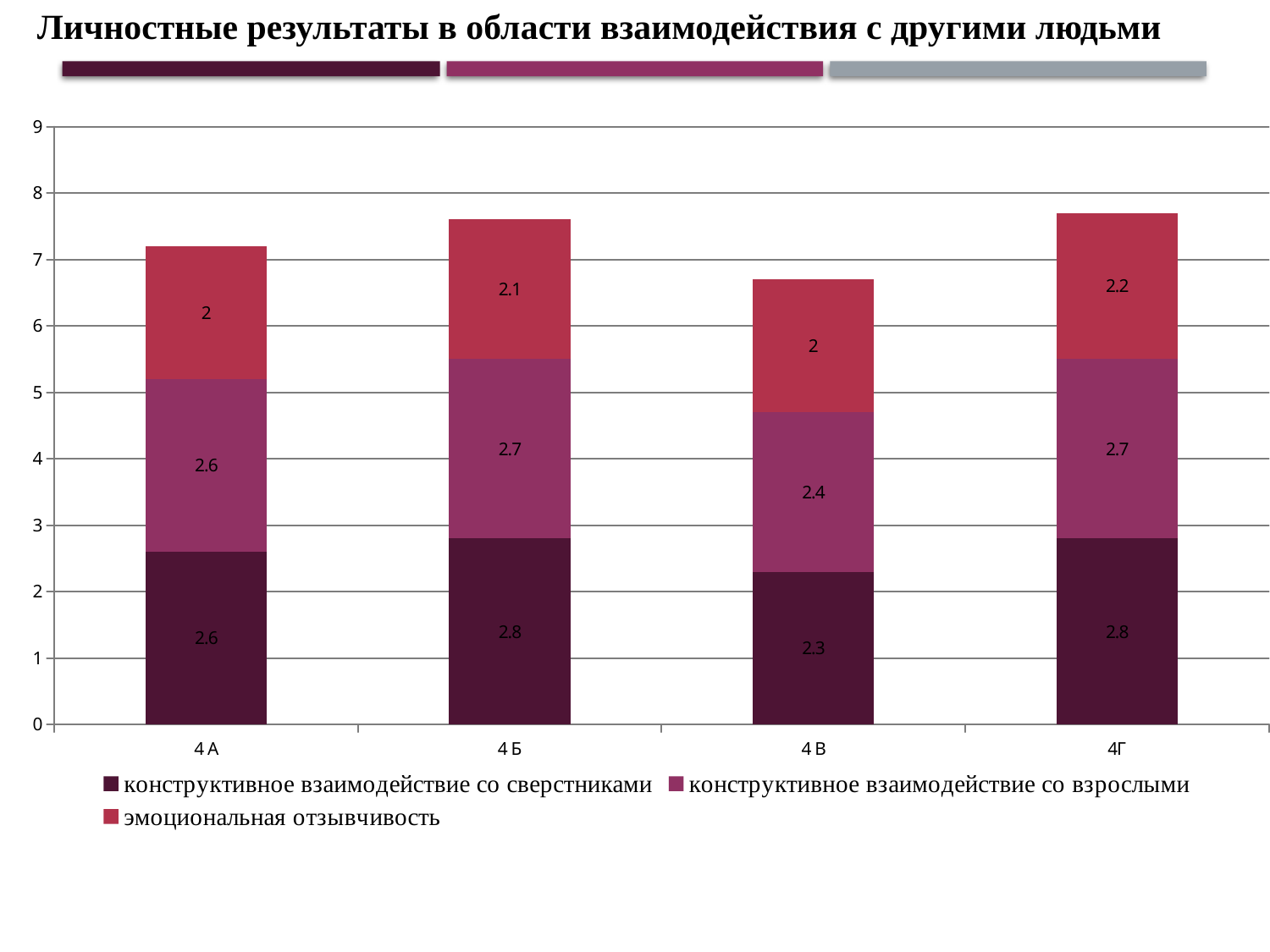
What is the difference between the 'конструктивное взаимодействие со взрослыми' values for 4 Б and 4 В? 0.3 Which category has the highest value for 'эмоциональная отзывчивость'? 4Г What is the total of the stacked bar for 4Г? 7.7 What is the value of 'конструктивное взаимодействие со сверстниками' for 4 В? 2.3 What is the value of 'конструктивное взаимодействие со взрослыми' for 4 А? 2.6 Which category has the lowest value for 'конструктивное взаимодействие со сверстниками'? 4 В How many series does the legend list? 3 How many categories are shown on the x axis? 4 What is the value of 'эмоциональная отзывчивость' for 4Г? 2.2 Which is larger: 'конструктивное взаимодействие со сверстниками' for 4 А or for 4 Б? 4 Б What kind of chart is shown on the slide? Stacked bar chart What is the total of the stacked bar for 4 В? 6.7